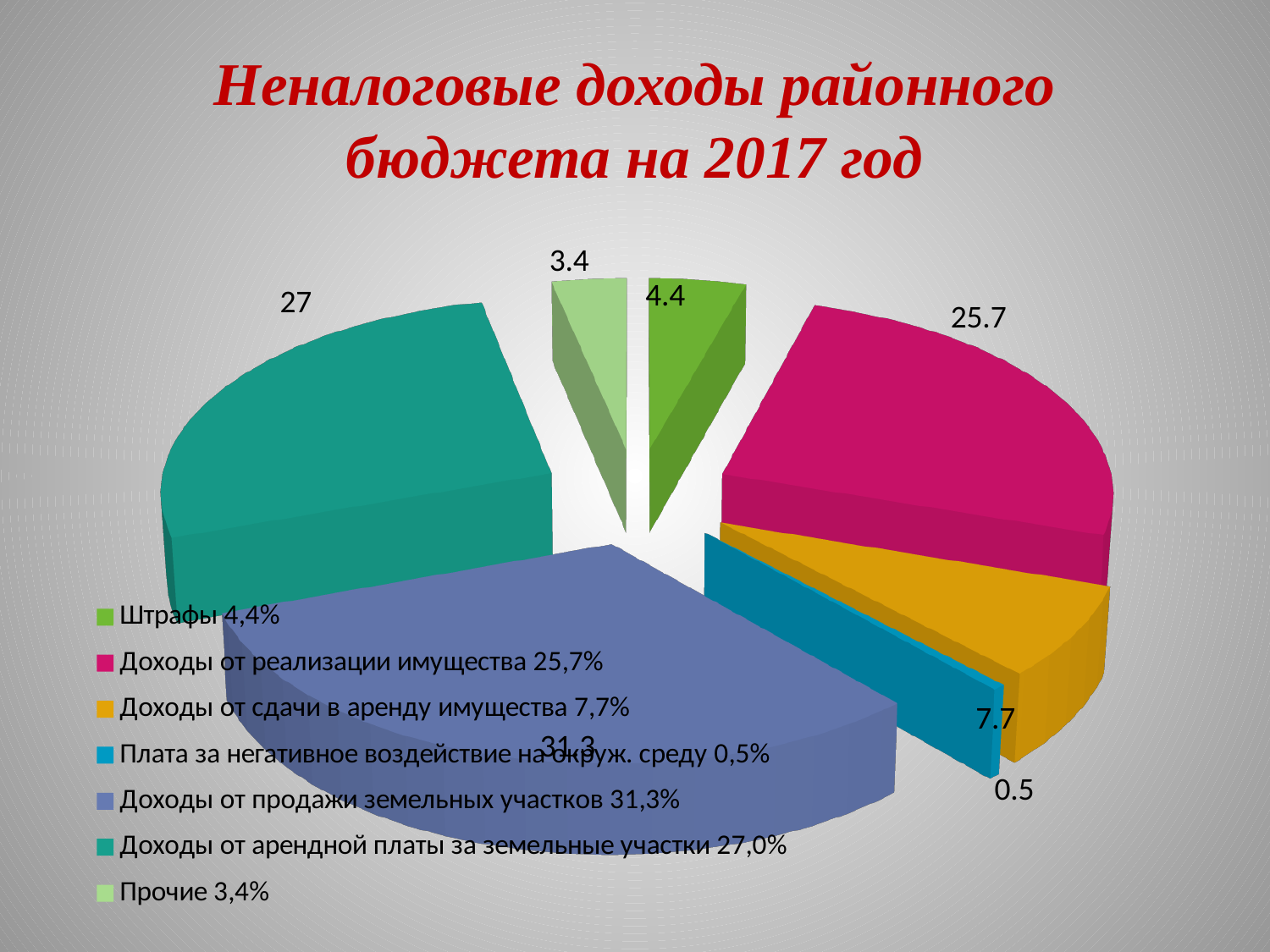
What is the title of the slide containing the chart? Неналоговые доходы районного бюджета на 2017 год What is the data label for Доходы от арендной платы за земельные участки? 27 How many slices does the pie chart have? 7 What is the data label for Доходы от реализации имущества? 25.7 What type of chart is shown on the slide? pie chart Which category has the largest slice of the pie? Доходы от продажи земельных участков What is the data label for Плата за негативное воздействие на окруж. среду? 0.5 Which category has the smallest slice of the pie? Плата за негативное воздействие на окруж. среду What is the data label for Штрафы? 4.4 What is the difference between the data labels for Доходы от продажи земельных участков and Доходы от реализации имущества? 5.6 What is the data label for Доходы от сдачи в аренду имущества? 7.7 Which is larger: the slice for Доходы от реализации имущества or the slice for Доходы от арендной платы за земельные участки? Доходы от арендной платы за земельные участки